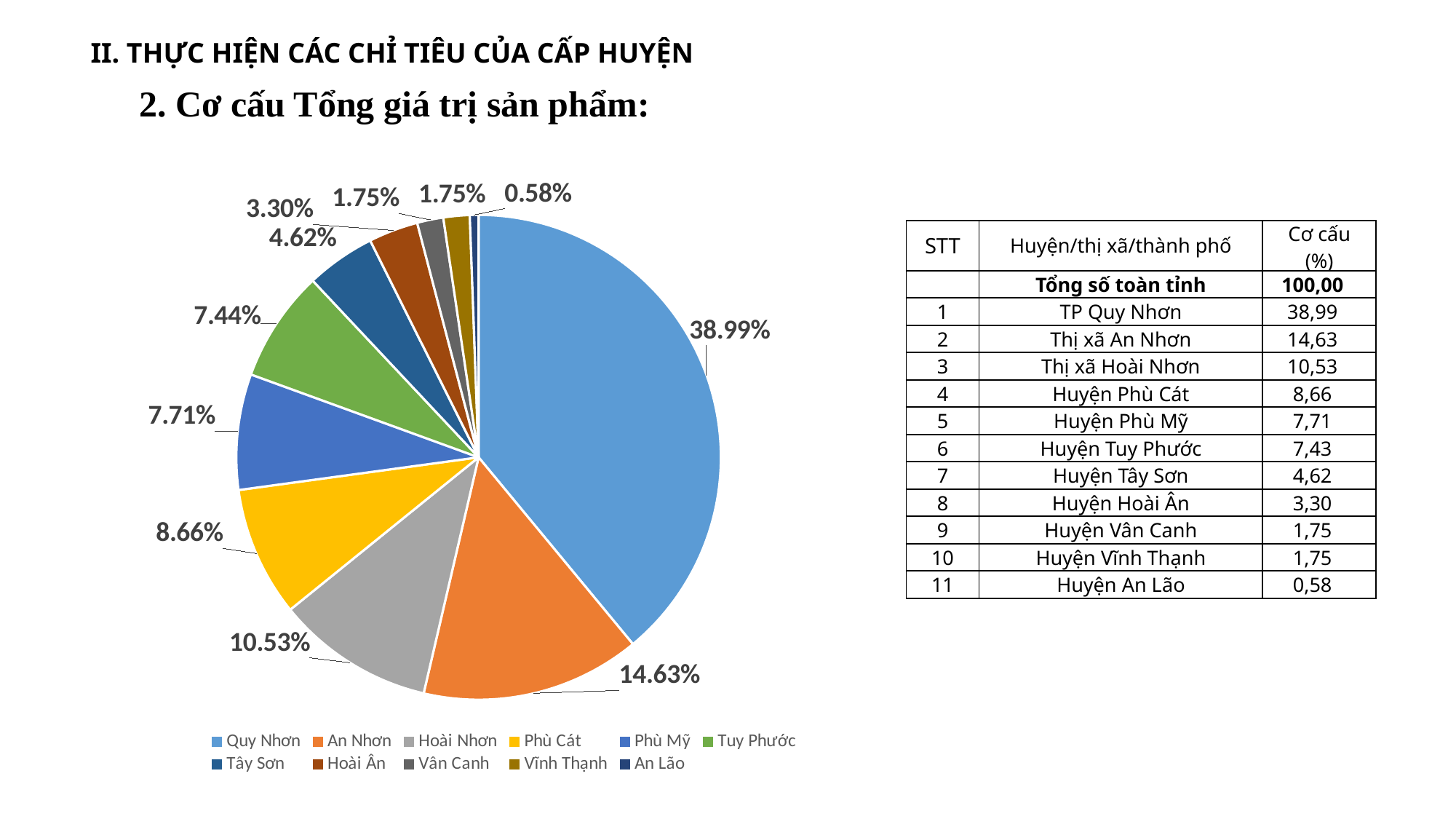
What is the value shown for Hoài Nhơn in the pie chart? 10.53% What is the difference between the Quy Nhơn and An Nhơn shares in the pie chart? 24.36% What colour is the Quy Nhơn slice in the pie chart? light blue Which slice of the pie chart is the largest? Quy Nhơn How many slices does the pie chart have? 11 Which slice of the pie chart is the smallest? An Lão What kind of chart is shown on the slide? pie chart What is the value shown for Tây Sơn in the pie chart? 4.62% What share of the pie does Quy Nhơn have? 38.99% What is the value shown for Phù Cát in the pie chart? 8.66% Which is larger in the pie chart, Phù Mỹ or Tuy Phước? Phù Mỹ What is the value shown for An Nhơn in the pie chart? 14.63%